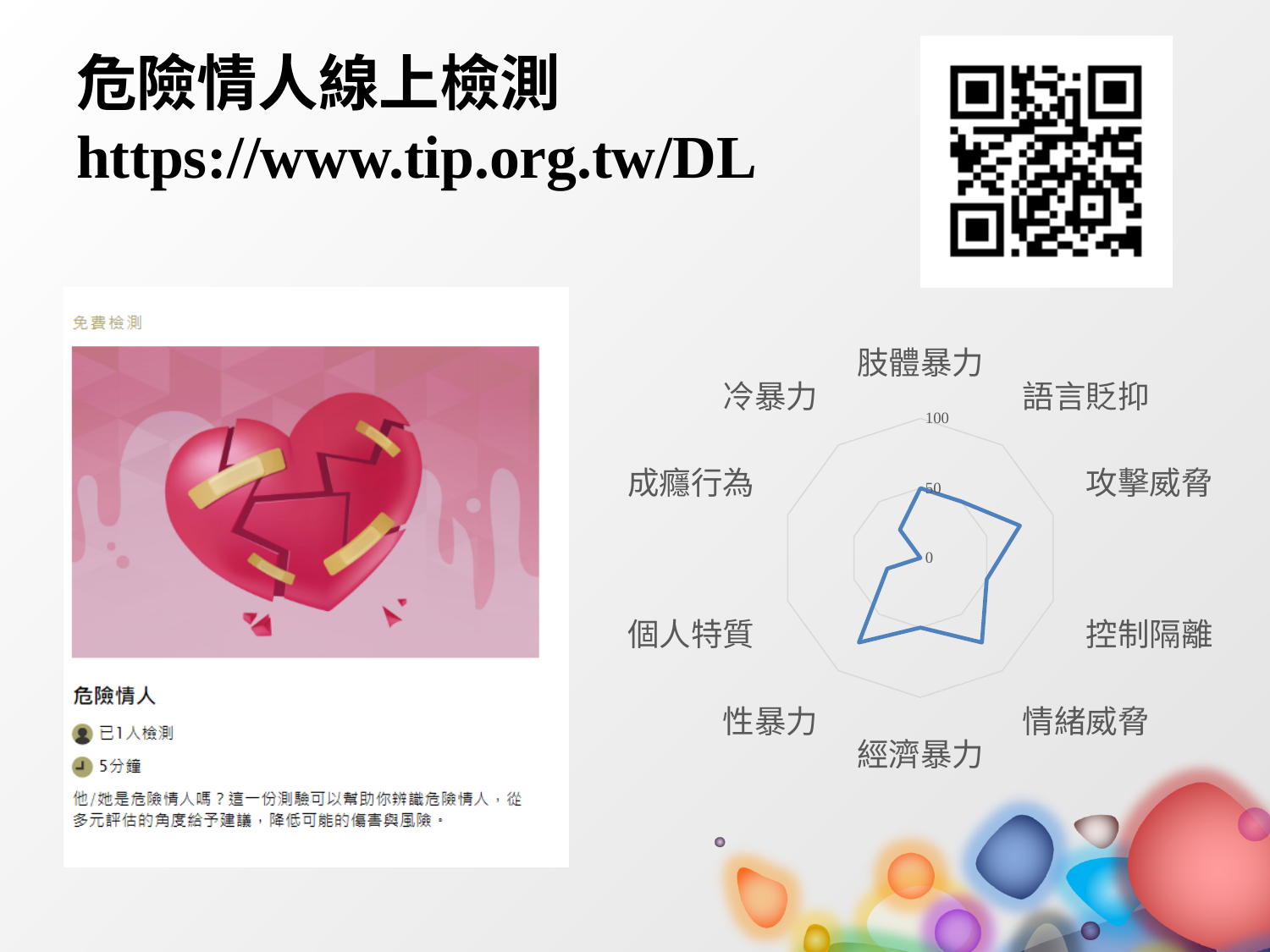
What kind of chart is shown on the right side of the slide? radar chart Is the value for 成癮行為 greater or less than 50? less Which category is at the top of the radar chart? 肢體暴力 What is the maximum value shown on the radar chart's scale? 100 Is the value for 個人特質 greater or less than 50? less Is the value for 個人特質 greater or less than 100? less Which has the larger value, 情緒威脅 or 冷暴力? 情緒威脅 How many categories (axes) does the radar chart have? 10 Which has the larger value, 個人特質 or 成癮行為? 個人特質